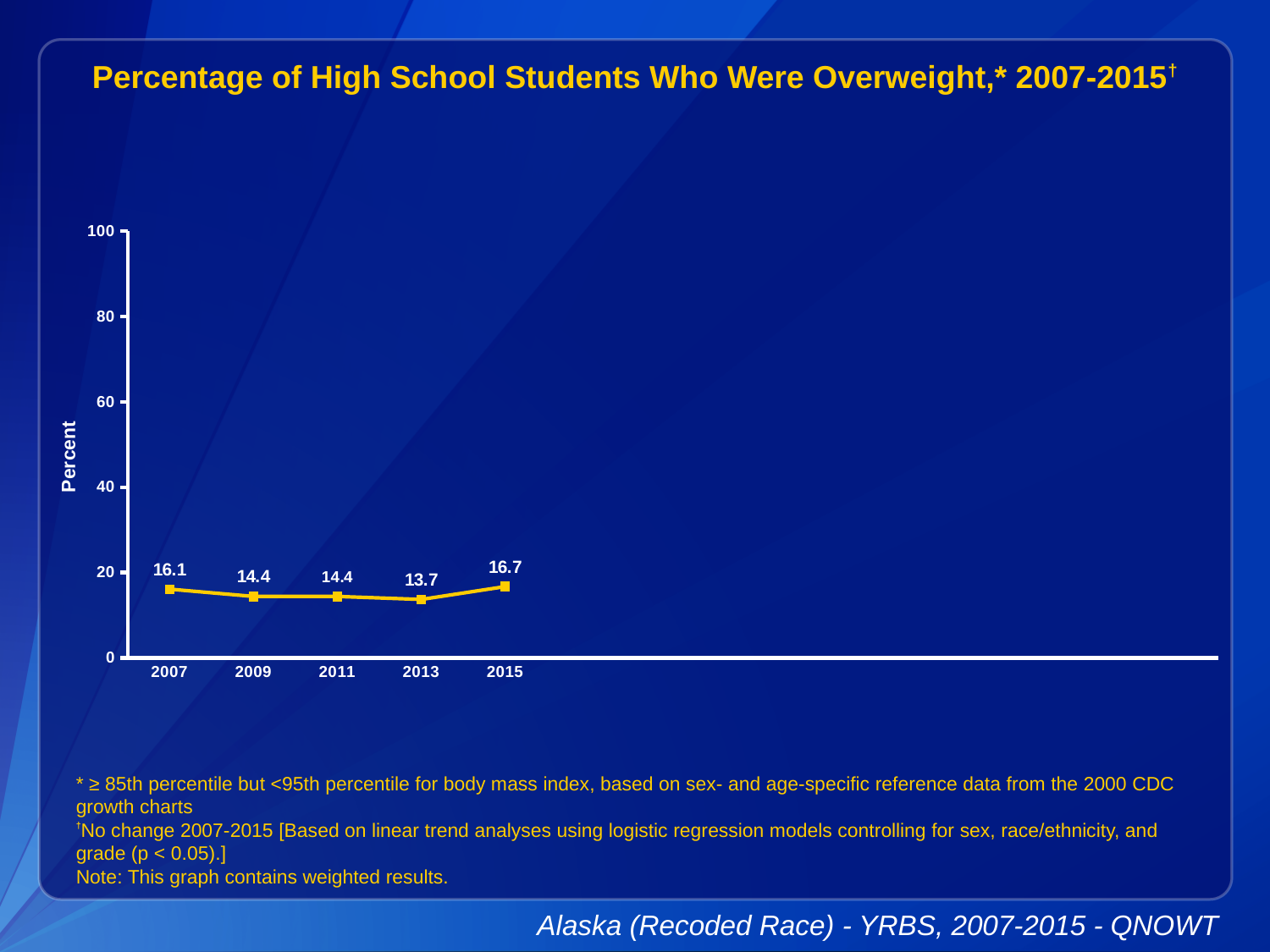
How many years are plotted on the chart? 5 What is the title of the chart? Percentage of High School Students Who Were Overweight,* 2007-2015† What kind of chart is shown on the slide? line chart What is the difference between the 2015 value and the 2013 value? 3.0 Which is larger, the value for 2007 or the value for 2009? 2007 Which year has the highest percentage of overweight students? 2015 What percentage of high school students were overweight in 2007? 16.1 Which year has the lowest percentage of overweight students? 2013 Is the value for 2011 greater or less than 20? less What is the value plotted for 2013? 13.7 What is the value plotted for 2015? 16.7 What is the label on the vertical axis? Percent